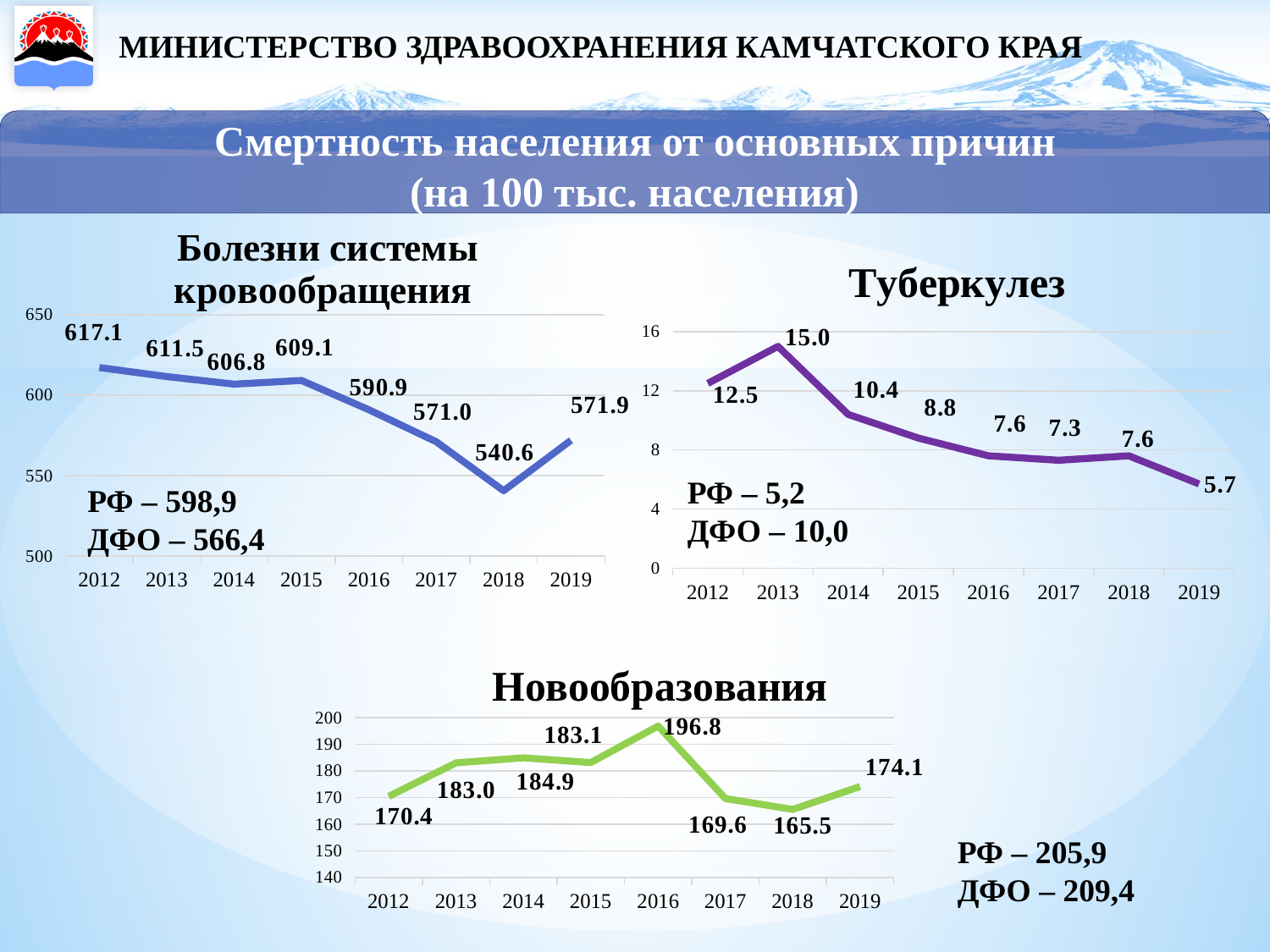
On the "Болезни системы кровообращения" chart, which year has the lowest value? 2018 How many years are plotted on the "Новообразования" chart? 8 On the "Новообразования" chart, which year has the lowest value? 2018 On the "Болезни системы кровообращения" chart, what is the difference between the 2012 and 2018 values? 76.5 On the "Туберкулез" chart, what is the value for 2013? 15.0 On the "Туберкулез" chart, is the value for 2014 greater or less than 12? less On the "Болезни системы кровообращения" chart, what is the value for 2012? 617.1 On the "Новообразования" chart, which is larger, the value for 2013 or the value for 2017? 2013 On the "Новообразования" chart, what is the value for 2016? 196.8 What kind of chart is the "Туберкулез" chart? line chart On the "Туберкулез" chart, what is the value for 2019? 5.7 On the "Туберкулез" chart, which year has the highest value? 2013